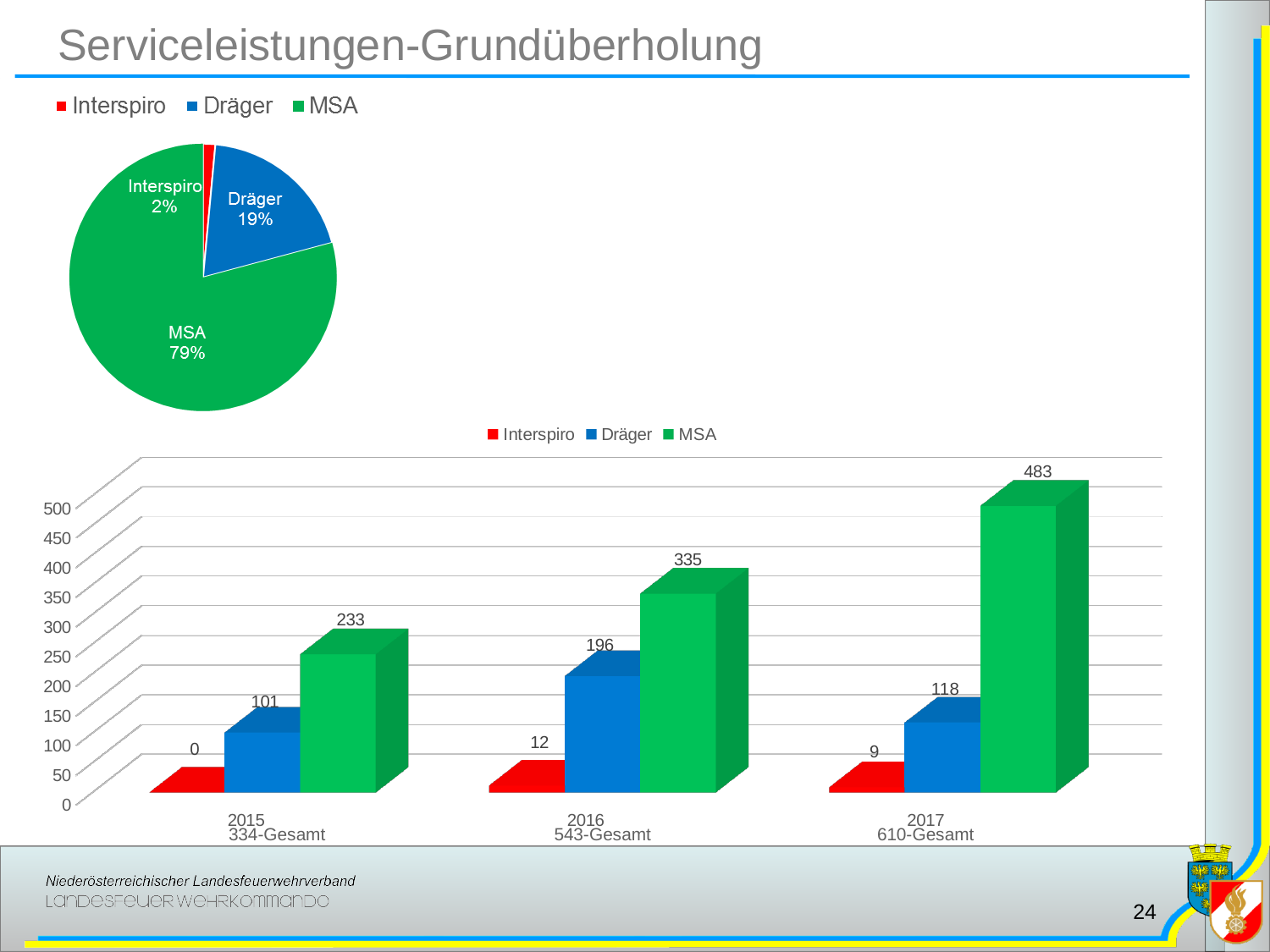
In the bar chart at the bottom, what is the total (Gesamt) shown for 2016? 543 In the bar chart at the bottom, what is the difference between the MSA values for 2017 and 2016? 148 In the pie chart at the top left, what share does MSA have? 79% In the bar chart at the bottom, what is the value for Dräger in 2016? 196 How many series does the legend of the bar chart at the bottom list? 3 In the pie chart at the top left, what share does Dräger have? 19% In the bar chart at the bottom, what is the value for MSA in 2017? 483 In the bar chart at the bottom, which year has the highest MSA value? 2017 What kind of chart is the chart at the top left of the slide? pie chart In the bar chart at the bottom, do the MSA values rise or fall from 2015 to 2017? rise In the bar chart at the bottom, is the Dräger value larger in 2016 or in 2017? 2016 In the bar chart at the bottom, what is the value for Interspiro in 2015? 0